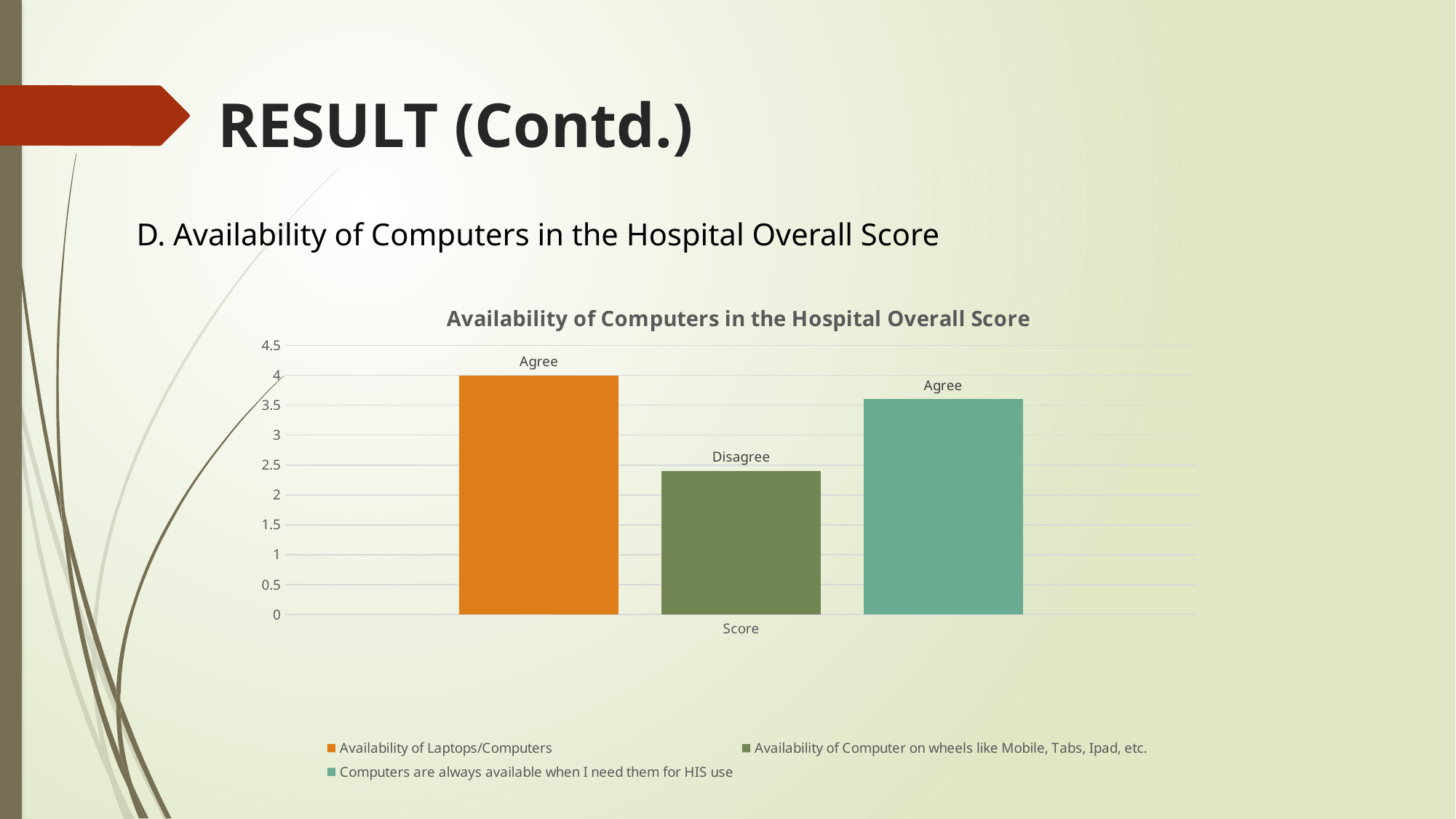
Which series has the lowest bar? Availability of Computer on wheels like Mobile, Tabs, Ipad, etc. What is the category label shown on the x axis? Score What data label is shown above the bar for Availability of Computer on wheels like Mobile, Tabs, Ipad, etc.? Disagree What is the title of the chart? Availability of Computers in the Hospital Overall Score What type of chart is shown on the slide? bar chart Is the value for Computers are always available when I need them for HIS use greater or less than 3? greater Is the value for Availability of Computer on wheels like Mobile, Tabs, Ipad, etc. greater or less than 3? less What is the value for Availability of Laptops/Computers? 4 How many bars are plotted in the chart? 3 How many series does the legend list? 3 Which is larger: the value for Availability of Laptops/Computers or the value for Computers are always available when I need them for HIS use? Availability of Laptops/Computers Which series has the highest bar? Availability of Laptops/Computers